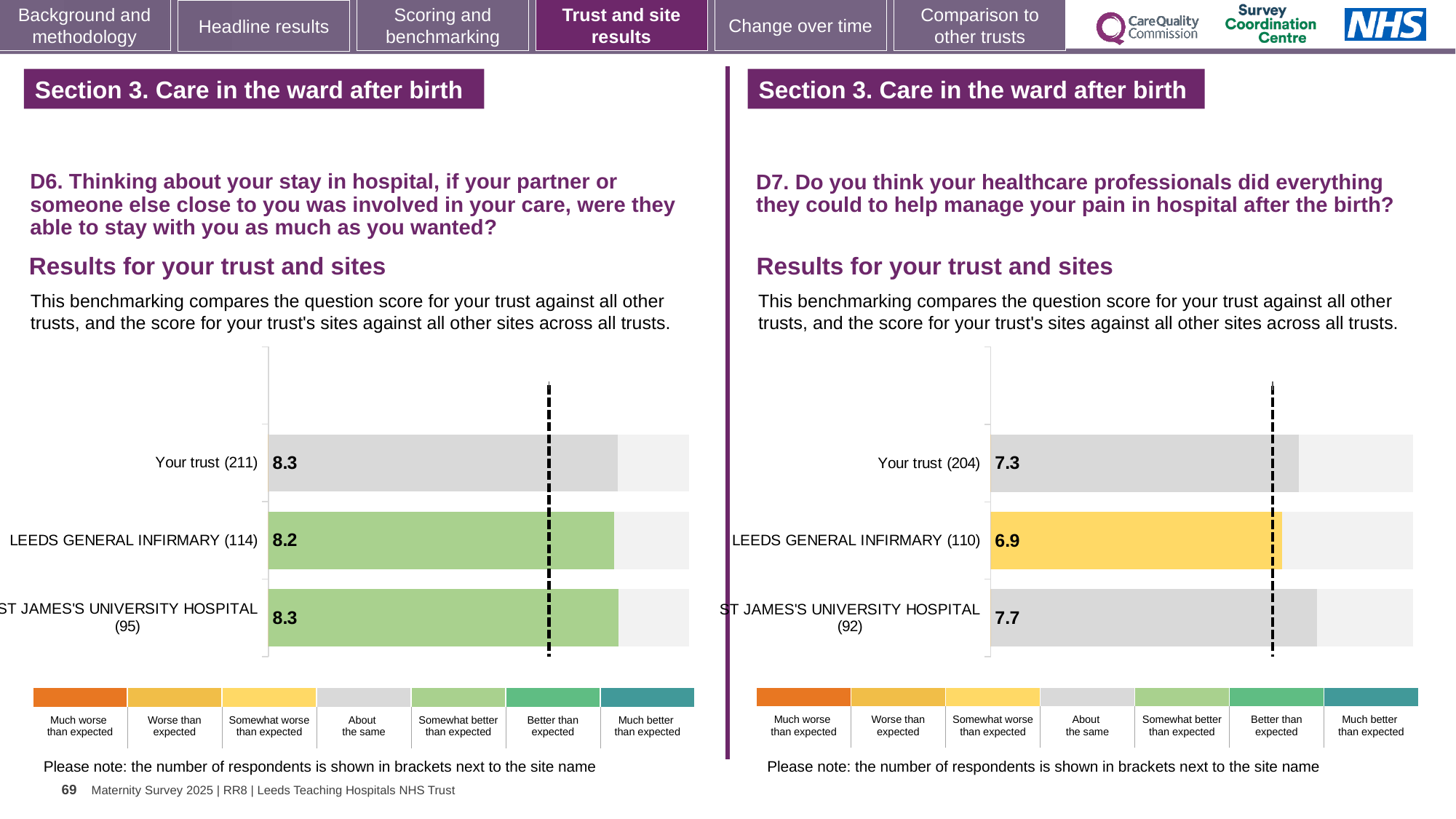
What kind of chart is used on the D7 chart (right)? Bar chart On the D7 chart (right), what is the score for ST JAMES'S UNIVERSITY HOSPITAL (92)? 7.7 On the D6 chart (left), which site or trust has the lowest score? LEEDS GENERAL INFIRMARY (114) On the D7 chart (right), which site or trust has the highest score? ST JAMES'S UNIVERSITY HOSPITAL (92) On the D7 chart (right), which site or trust has the lowest score? LEEDS GENERAL INFIRMARY (110) On the D7 chart (right), what is the difference between the scores for ST JAMES'S UNIVERSITY HOSPITAL (92) and LEEDS GENERAL INFIRMARY (110)? 0.8 On the D6 chart (left), what is the score for Your trust (211)? 8.3 On the D7 chart (right), what is the score for LEEDS GENERAL INFIRMARY (110)? 6.9 On the D7 chart (right), which has the larger score: Your trust (204) or ST JAMES'S UNIVERSITY HOSPITAL (92)? ST JAMES'S UNIVERSITY HOSPITAL (92) On the D6 chart (left), what is the score for LEEDS GENERAL INFIRMARY (114)? 8.2 On the D7 chart (right), which benchmark category does the colour of the LEEDS GENERAL INFIRMARY (110) bar correspond to? Somewhat worse than expected How many bars are shown on the D6 chart (left)? 3